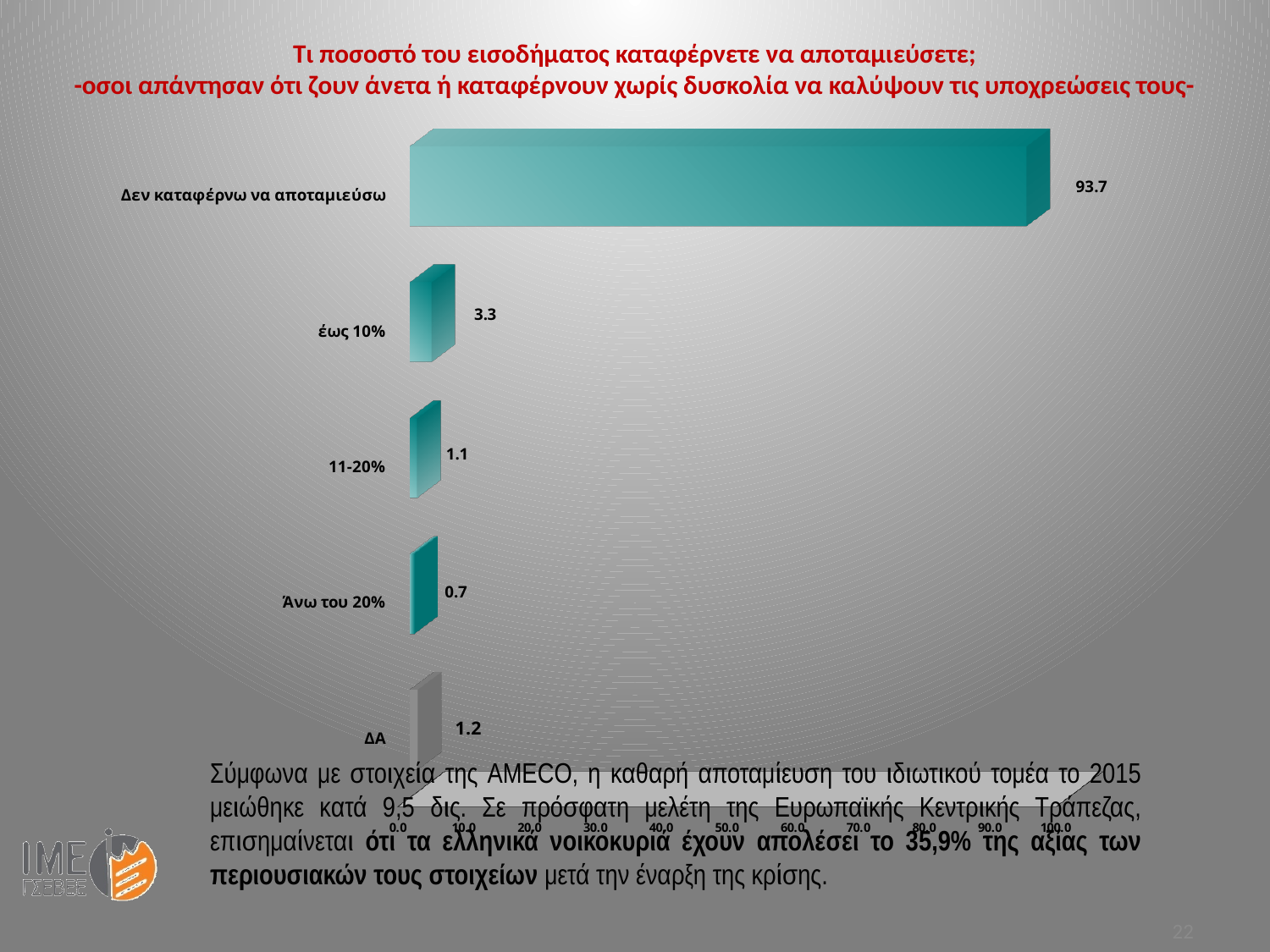
What value is shown for the category "Άνω του 20%"? 0.7 Which is larger, the value for "έως 10%" or the value for "ΔΑ"? έως 10% Which category has the lowest value? Άνω του 20% What value is shown for the category "Δεν καταφέρνω να αποταμιεύσω"? 93.7 What is the difference between the values for "Δεν καταφέρνω να αποταμιεύσω" and "έως 10%"? 90.4 What value is shown for the category "11-20%"? 1.1 What kind of chart is shown on the slide? Bar chart What value is shown for the category "ΔΑ"? 1.2 What value is shown for the category "έως 10%"? 3.3 How many categories are shown in the chart? 5 Is the value for "Δεν καταφέρνω να αποταμιεύσω" greater or less than 90.0? greater Which category has the highest value? Δεν καταφέρνω να αποταμιεύσω